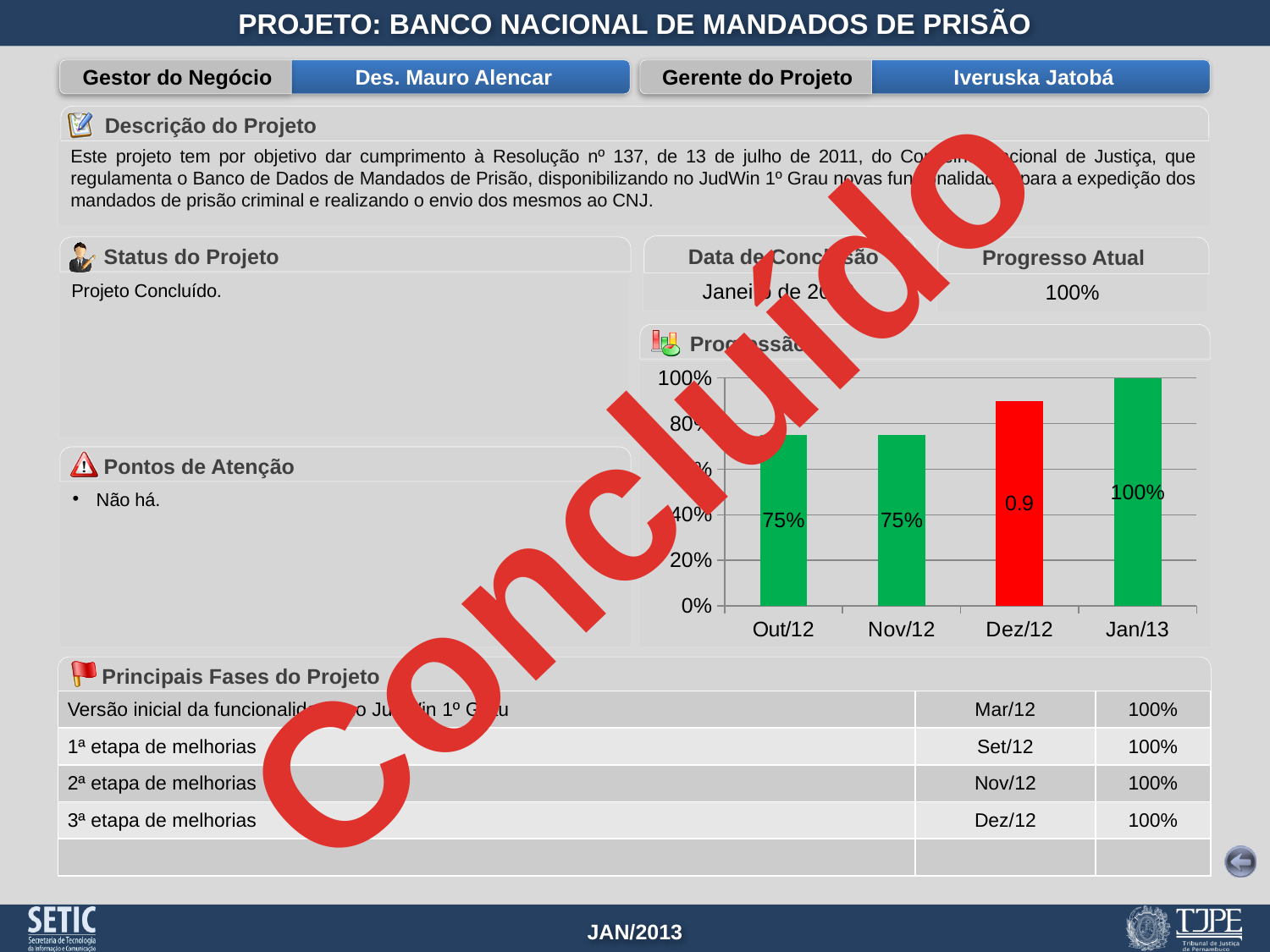
What colour is the Dez/12 bar in the chart? Red How many months are shown on the x axis of the chart? 4 What is the value shown for Jan/13 in the bar chart? 100% What is the difference between the values for Jan/13 and Out/12 in the chart? 25% Do the values in the chart rise or fall from Out/12 to Jan/13? Rise Which bar is taller in the chart, Dez/12 or Nov/12? Dez/12 What is the value shown for Nov/12 in the bar chart? 75% Is the value for Dez/12 in the chart greater or less than 80%? greater What is the value shown for Out/12 in the bar chart? 75% What data label is printed on the Dez/12 bar in the chart? 0.9 Which month has the highest bar in the chart? Jan/13 What kind of chart is shown on the slide? Bar chart